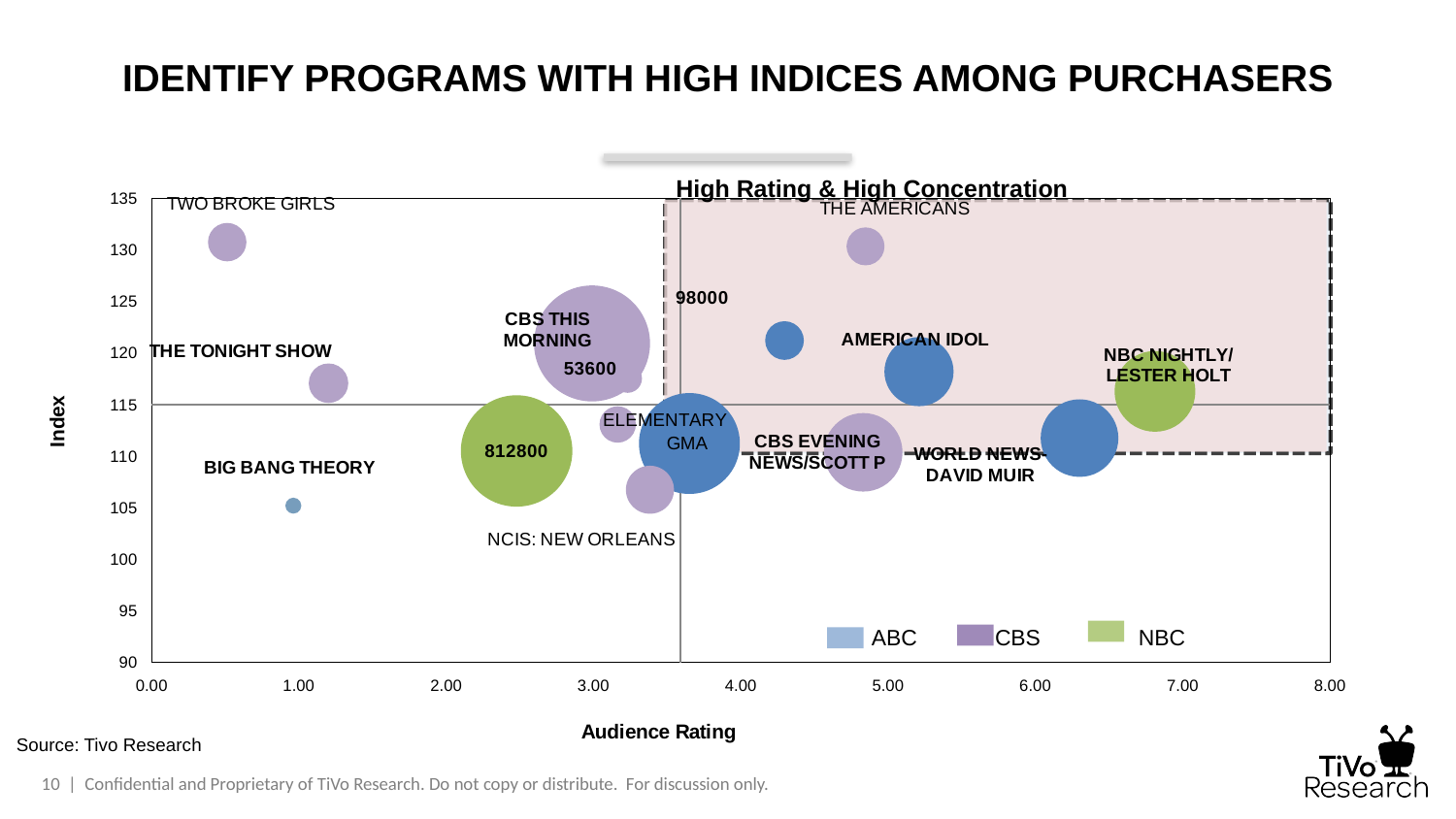
What kind of chart is shown on the slide? Bubble chart Is the Index value for THE AMERICANS greater or less than 125? greater Which program has the highest Audience Rating? NBC NIGHTLY/LESTER HOLT How many series does the legend list? 3 Is the Audience Rating for TWO BROKE GIRLS greater or less than 1.00? less Is the Index value for TWO BROKE GIRLS greater or less than 125? greater Which program has the lowest Audience Rating? TWO BROKE GIRLS Which has the higher Index, THE AMERICANS or AMERICAN IDOL? THE AMERICANS What is the label of the horizontal axis? Audience Rating Which networks are listed in the chart legend? ABC, CBS, NBC